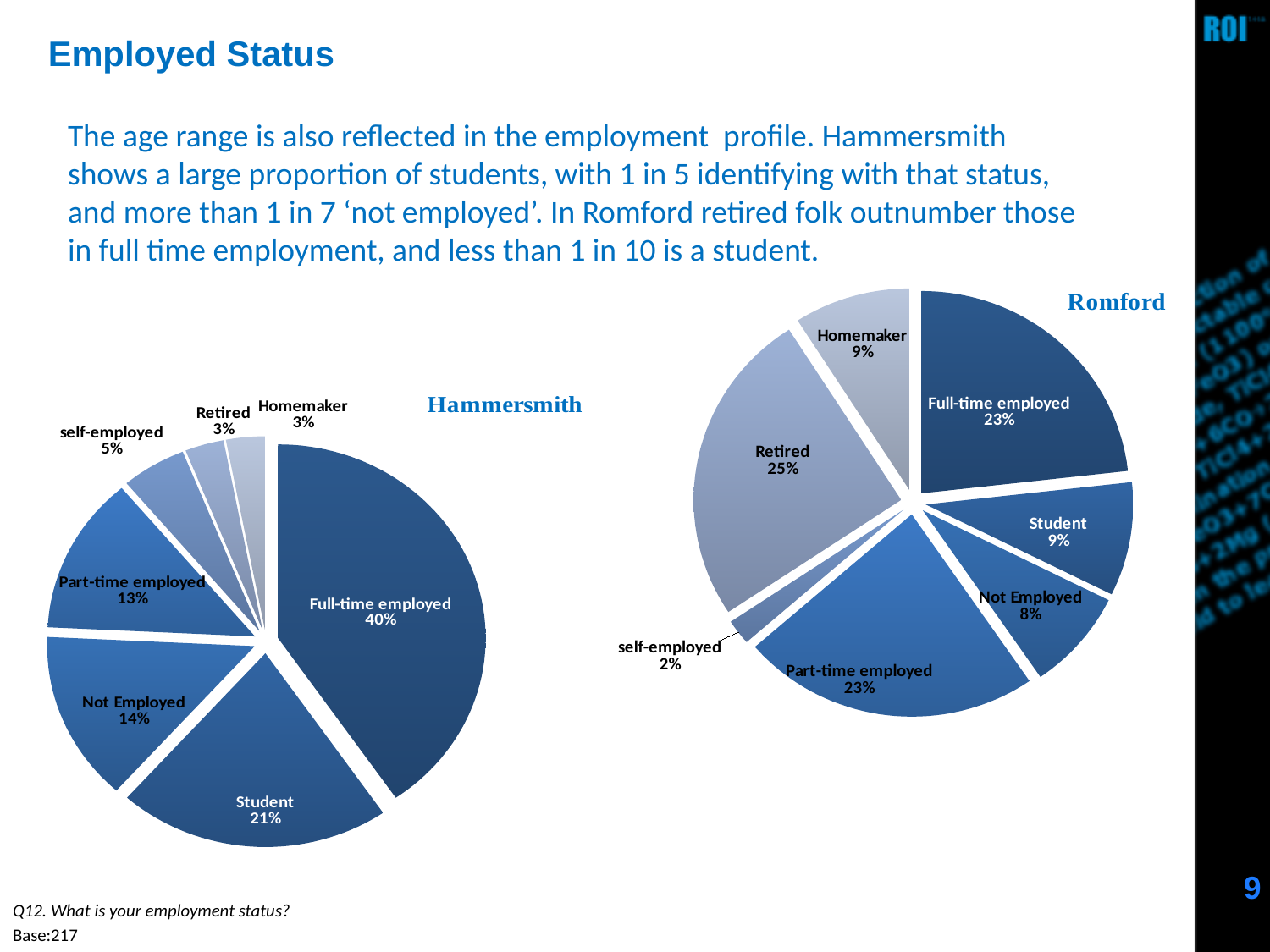
What type of chart is used for Hammersmith? Pie chart In the Romford pie chart, which is larger: Homemaker or self-employed? Homemaker In the Hammersmith pie chart, which category has the largest share? Full-time employed How many categories are shown in the Romford pie chart? 7 In the Hammersmith pie chart, what percentage is Full-time employed? 40% In the Hammersmith pie chart, what percentage is Part-time employed? 13% In the Romford pie chart, what is the difference between the Student share and the Not Employed share? 1% In the Hammersmith pie chart, what is the difference between the Student share and the Not Employed share? 7% In the Romford pie chart, what percentage is Retired? 25% In the Romford pie chart, which category has the smallest share? self-employed What is the title of the slide containing the two pie charts? Employed Status In the Romford pie chart, which is larger: Retired or Full-time employed? Retired